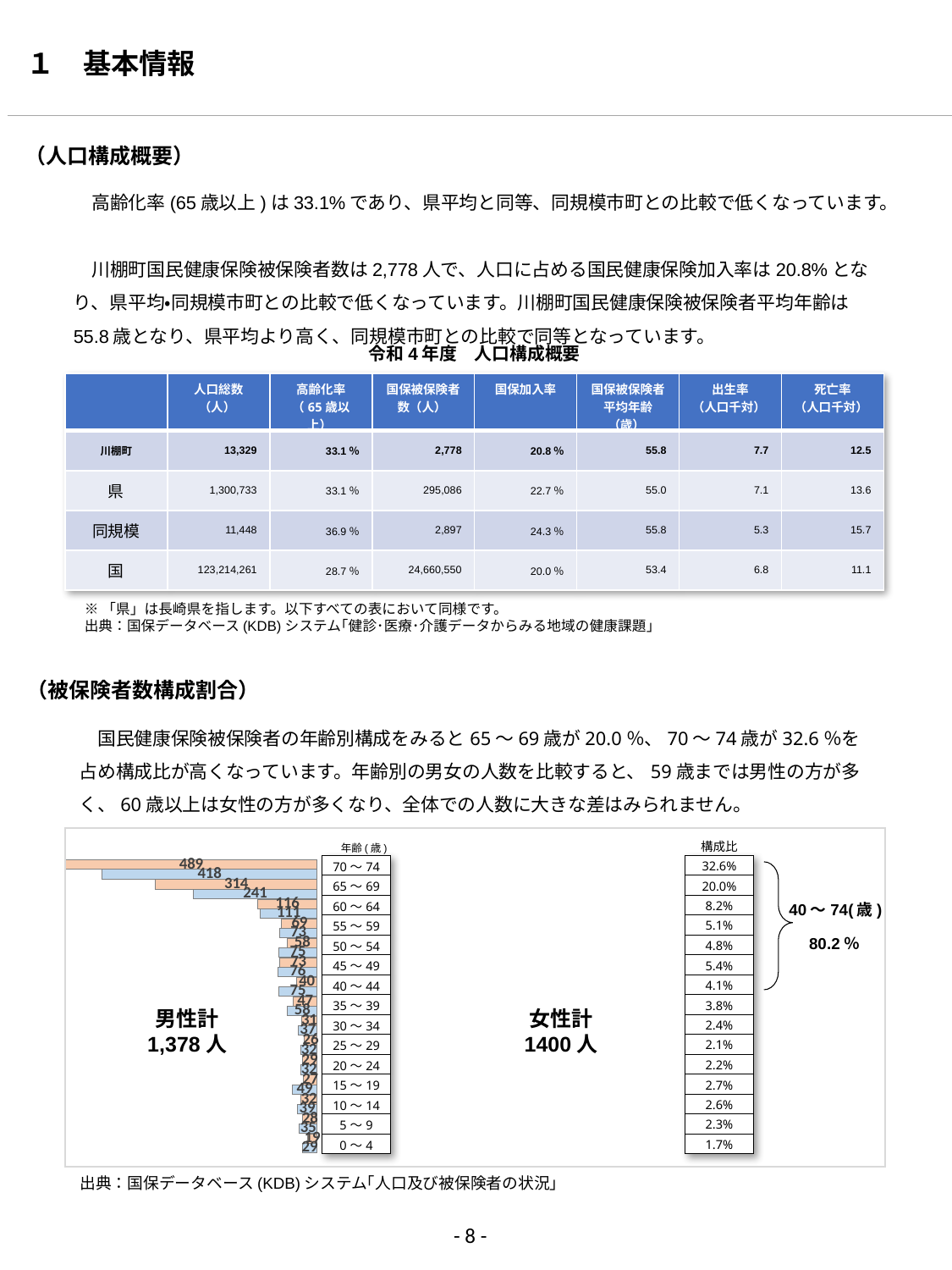
How many age groups are shown in the population pyramid chart? 15 What is the male total (男性計) shown in the population pyramid chart? 1,378 人 What is the female total (女性計) shown in the population pyramid chart? 1400 人 In the population pyramid chart, what is the 構成比 for the 70～74 age group? 32.6% According to the population pyramid chart, what share of insured persons is in the 40～74 age range? 80.2% Which age group has the lowest 構成比 in the population pyramid chart? 0～4 What kind of chart is shown in the 被保険者数構成割合 section? bar chart In the population pyramid chart, what is the difference in 構成比 between the 70～74 and 65～69 age groups? 12.6% In the population pyramid chart, which age group has a larger 構成比, 60～64 or 55～59? 60～64 In the population pyramid chart, what is the 構成比 for the 65～69 age group? 20.0% In the population pyramid chart, what is the 構成比 for the 15～19 age group? 2.7% Which age group has the highest 構成比 in the population pyramid chart? 70～74